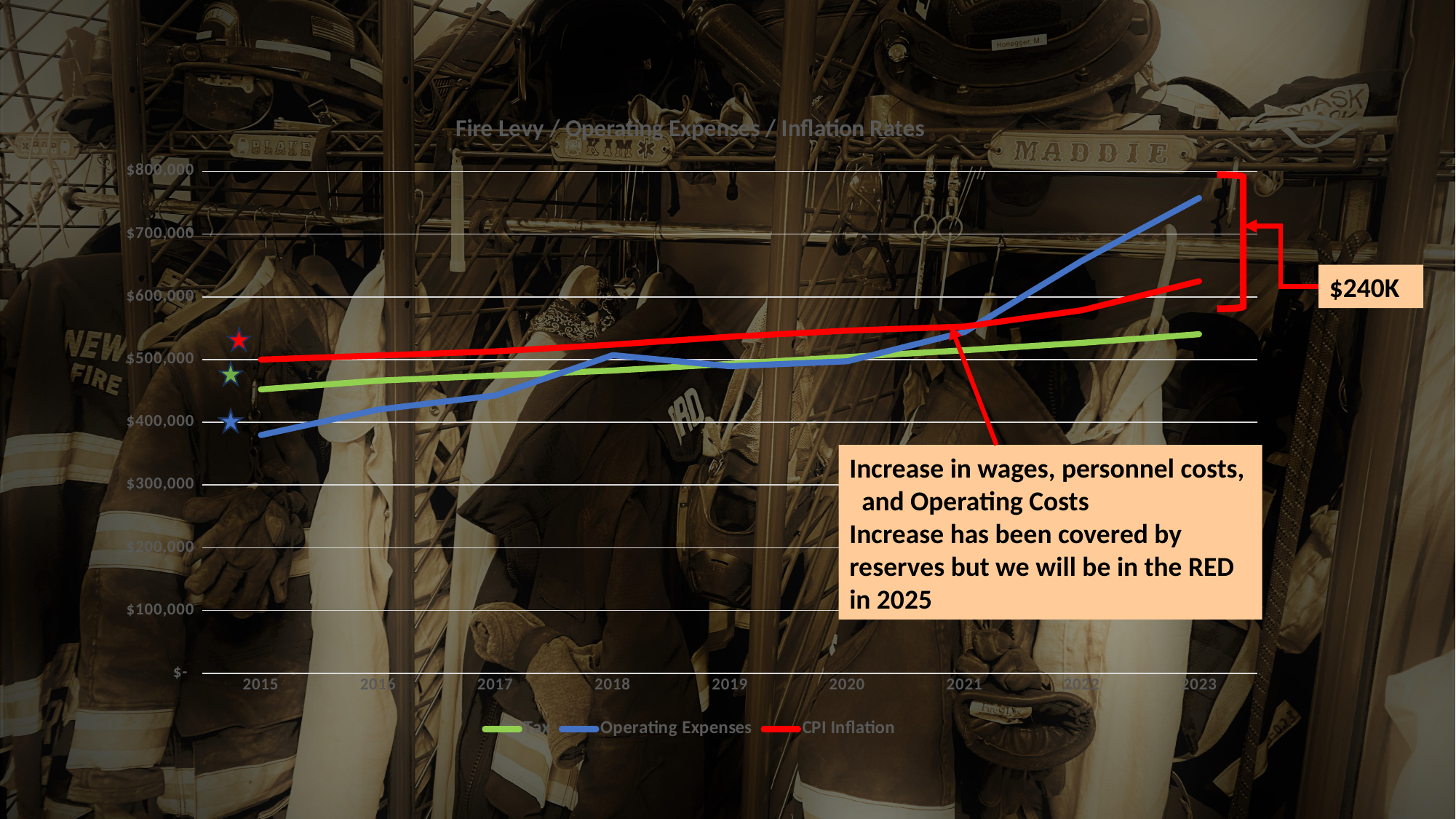
What is the title of the chart? Fire Levy / Operating Expenses / Inflation Rates Is the value for Operating Expenses in 2023 greater or less than $700,000? greater In 2023, which is larger: Operating Expenses or Tax? Operating Expenses Does the Tax series rise or fall from 2015 to 2023? Rise How many series does the chart's legend list? 3 In 2015, which is larger: CPI Inflation or Operating Expenses? CPI Inflation How many years are shown along the x axis of the chart? 9 Is the value for Tax in 2015 greater or less than $500,000? less Which series has the highest value in 2023? Operating Expenses Is the value for Operating Expenses in 2015 greater or less than $500,000? less What kind of chart is shown on the slide? Line chart Which series has the lowest value in 2015? Operating Expenses